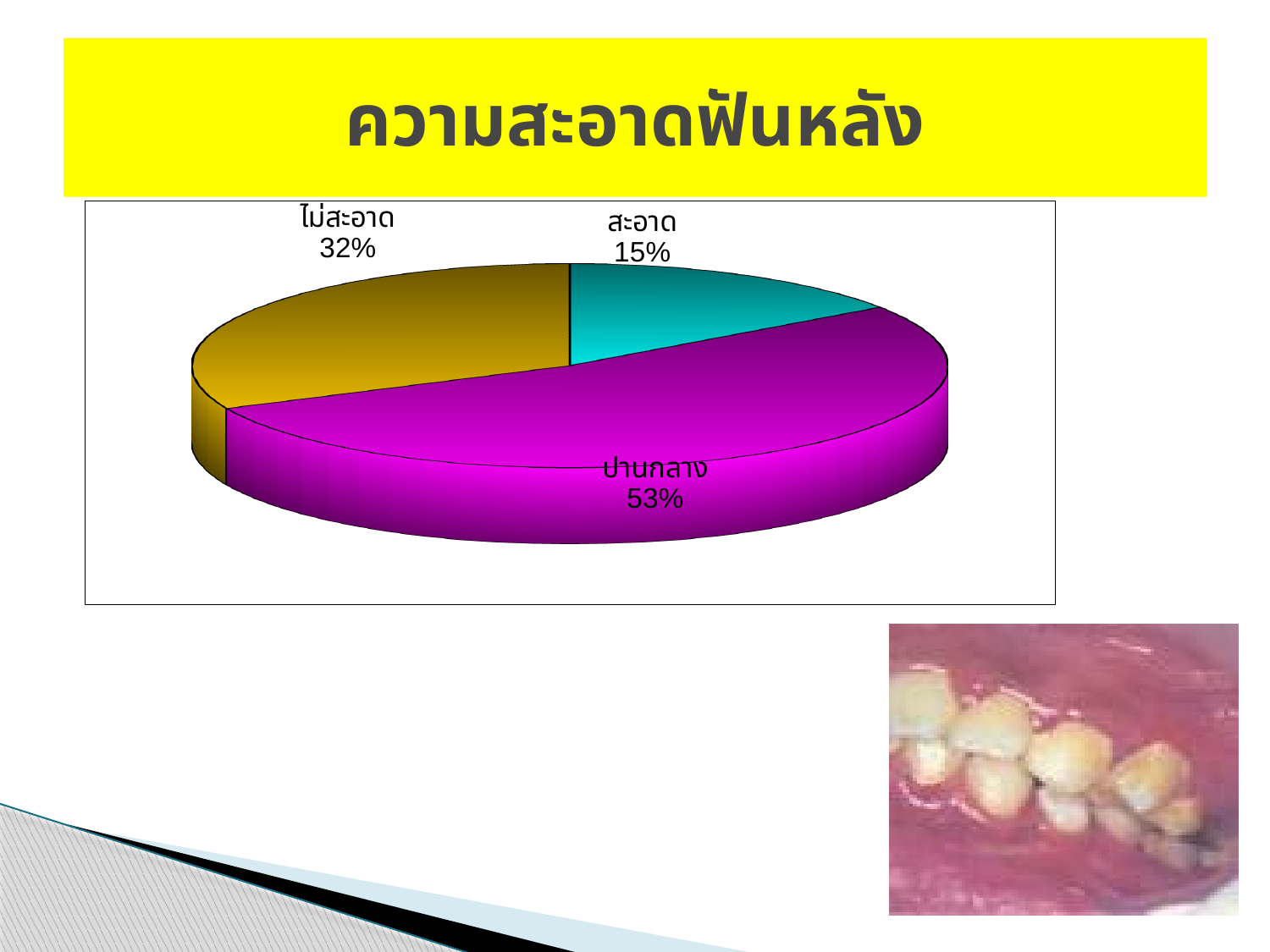
How many slices does the pie chart have? 3 What percentage is shown for ไม่สะอาด? 32% What colour is the ปานกลาง slice? magenta What kind of chart is shown on the slide? pie chart Which category has the smallest share of the pie? สะอาด Which category has the largest share of the pie? ปานกลาง What is the difference in percentage points between ไม่สะอาด and สะอาด? 17 What percentage is shown for สะอาด? 15% What percentage is shown for ปานกลาง? 53% What is the difference in percentage points between ปานกลาง and ไม่สะอาด? 21 Which is larger, the share for ไม่สะอาด or the share for สะอาด? ไม่สะอาด What is the title of the chart on the slide? ความสะอาดฟันหลัง